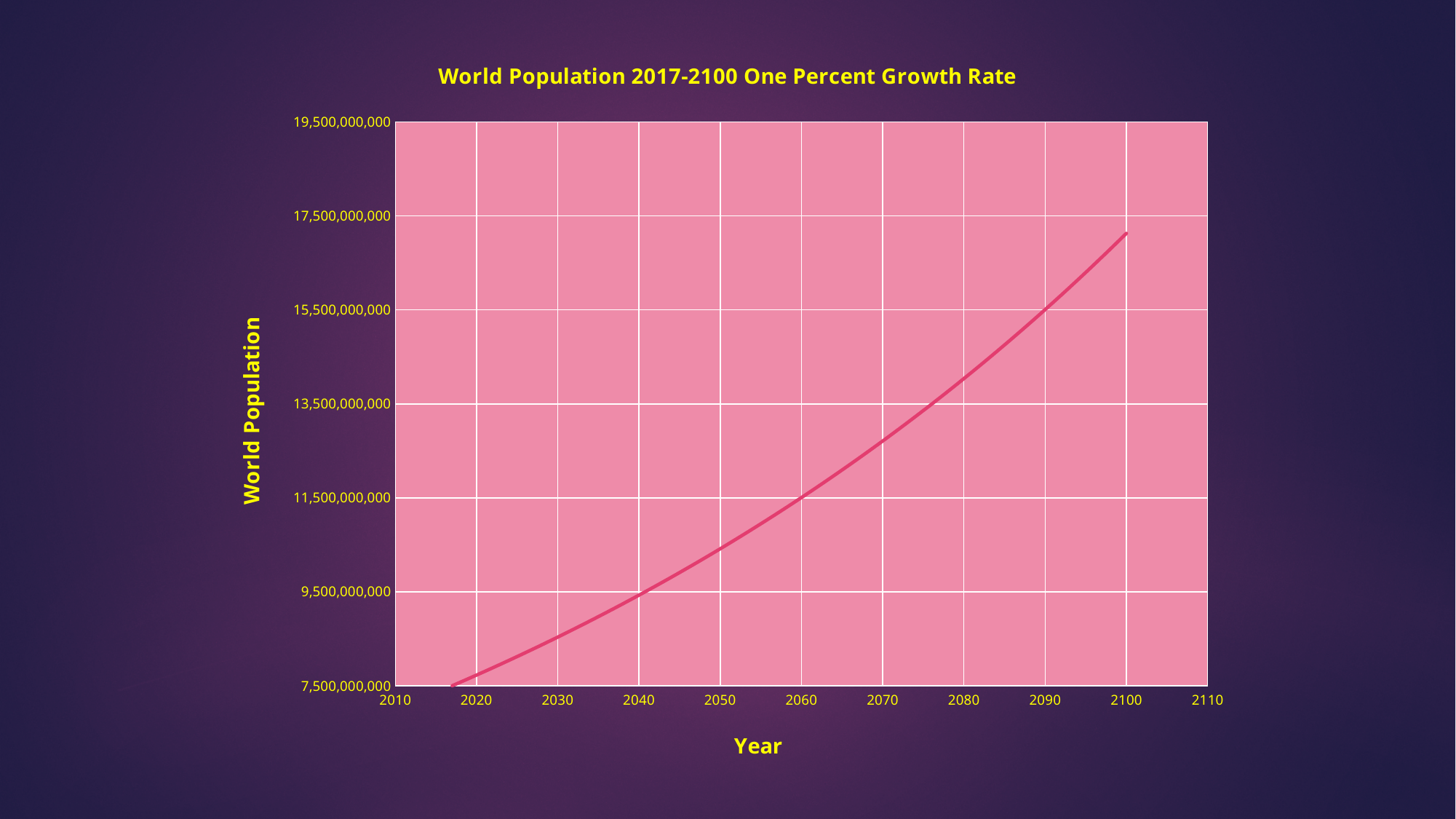
Is the world population value for 2050 greater or less than 11,500,000,000? less Is the world population value for 2030 greater or less than 9,500,000,000? less What kind of chart is shown on the slide? line chart Is the world population value for 2080 greater or less than 13,500,000,000? greater What is the title of the chart? World Population 2017-2100 One Percent Growth Rate Does the world population rise or fall as the year increases along the x axis? rise In which year plotted on the chart is the world population highest? 2100 What is the label on the y axis of the chart? World Population